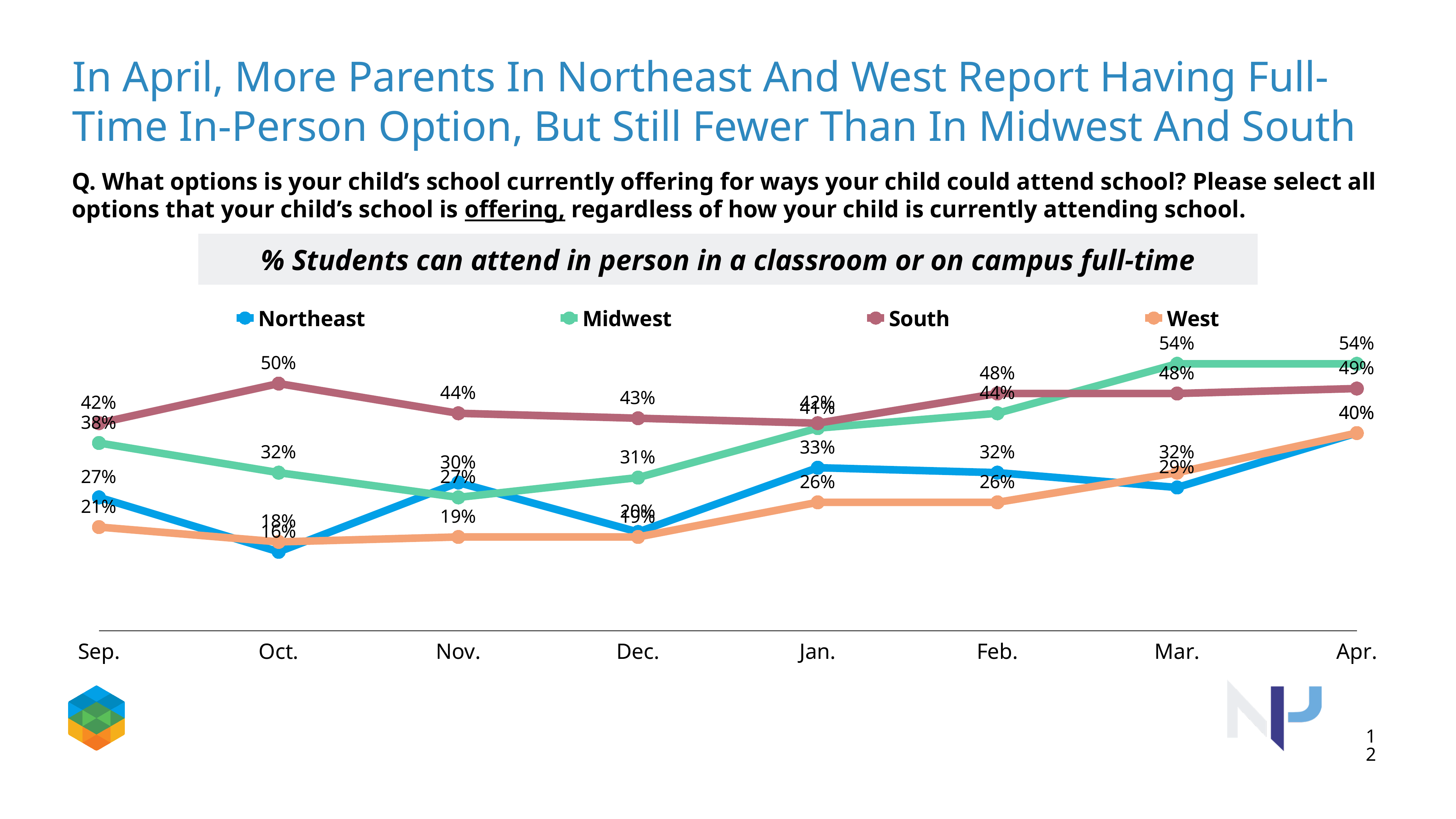
How many months are shown on the x axis? 8 What is the value for South in Oct.? 50% In which month is the South series at its highest? Oct. In Sep., which is larger: South or Midwest? South What type of chart is shown on the slide? Line chart What is the value for Northeast in Sep.? 27% What is the value for West in Jan.? 26% In which month is the Northeast series at its lowest? Oct. How many series does the legend list? 4 What is the title of the chart? % Students can attend in person in a classroom or on campus full-time What is the value for Midwest in Mar.? 54% What is the difference between Midwest and South in Apr.? 5 percentage points